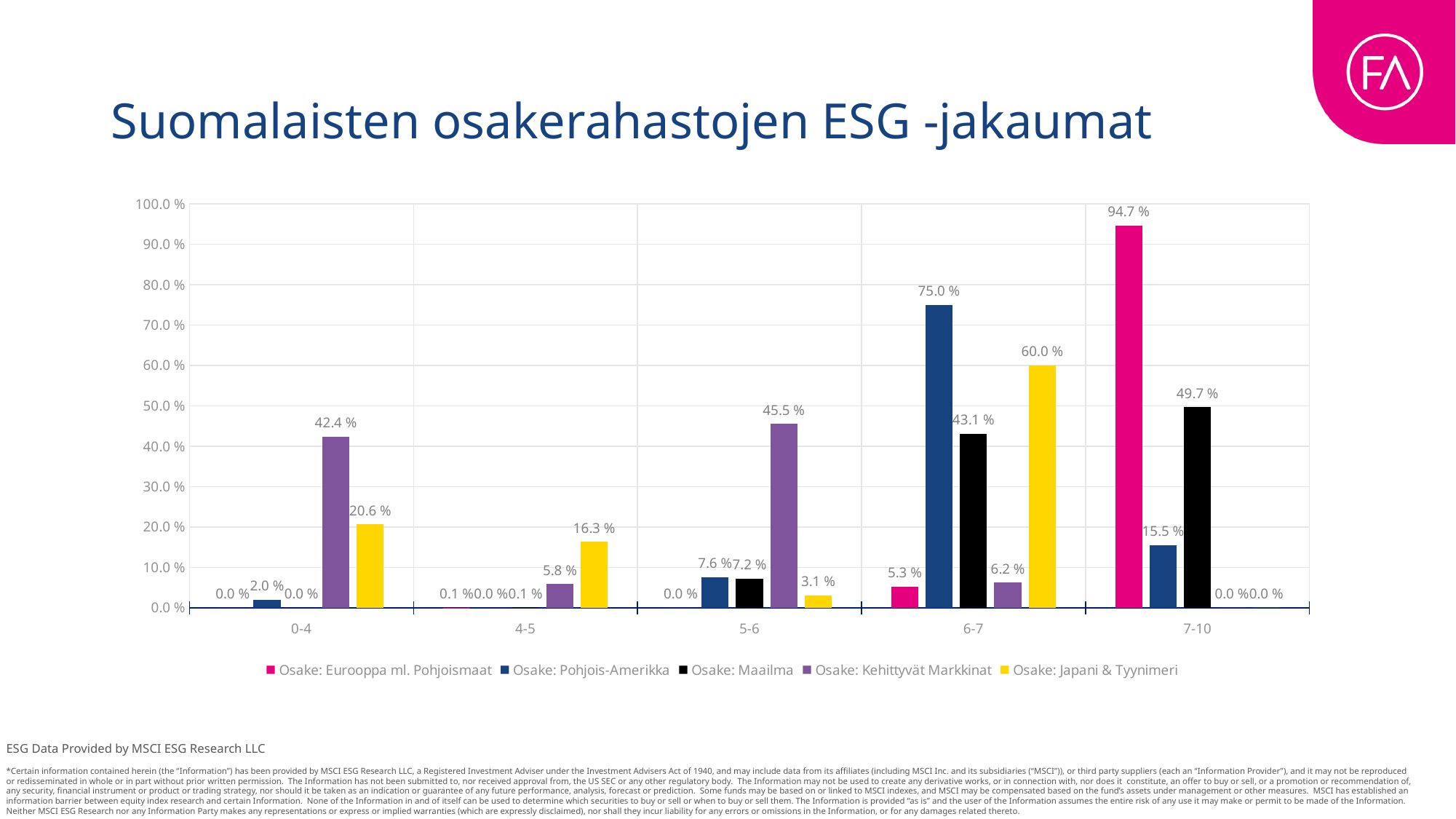
What is the value for Osake: Eurooppa ml. Pohjoismaat in the 7-10 category? 94.7 % Which category has the highest value for Osake: Maailma? 7-10 What is the title of the slide? Suomalaisten osakerahastojen ESG -jakaumat What kind of chart is shown on the slide? Bar chart How many categories are shown on the x axis? 5 What is the value for Osake: Japani & Tyynimeri in the 4-5 category? 16.3 % Which category has the highest value for Osake: Kehittyvät Markkinat? 5-6 What is the value for Osake: Kehittyvät Markkinat in the 0-4 category? 42.4 % In the 5-6 category, which is larger: Osake: Pohjois-Amerikka or Osake: Maailma? Osake: Pohjois-Amerikka What is the difference between Osake: Japani & Tyynimeri and Osake: Maailma in the 6-7 category? 16.9 % How many series does the legend list? 5 What is the value for Osake: Pohjois-Amerikka in the 6-7 category? 75.0 %